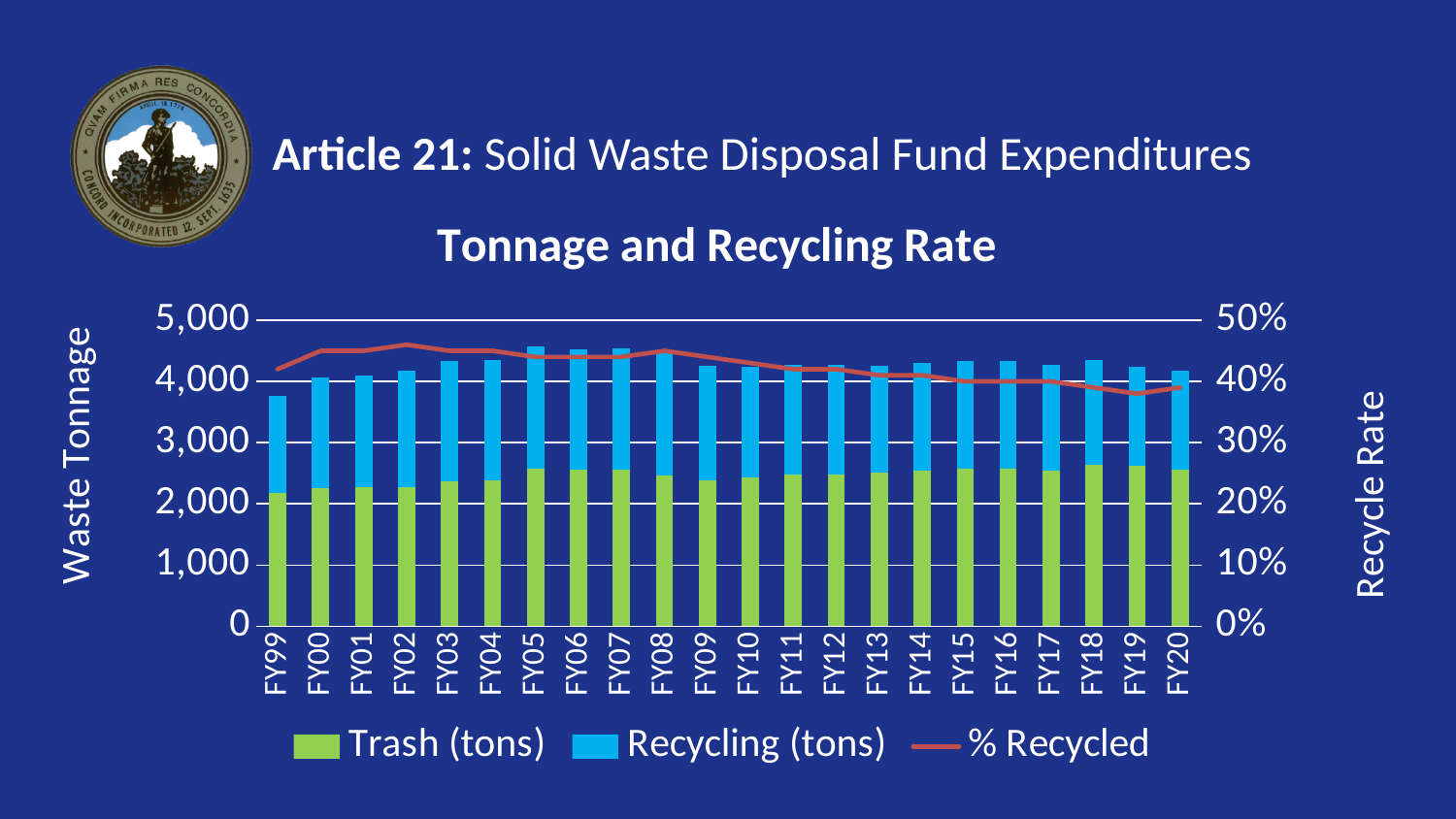
Which fiscal year has the lowest total waste tonnage bar? FY99 Is the % Recycled value for FY02 greater or less than 40%? greater Is the total waste tonnage bar for FY99 greater or less than 4,000? less Is the Trash (tons) value for FY99 greater or less than 2,000? greater Which series is plotted against the right-hand Recycle Rate axis? % Recycled How many fiscal years are shown on the x axis? 22 Does the % Recycled line rise or fall from FY08 to FY19? fall What is the title of the chart? Tonnage and Recycling Rate What kind of chart is shown on the slide? Bar chart with a line How many series does the legend list? 3